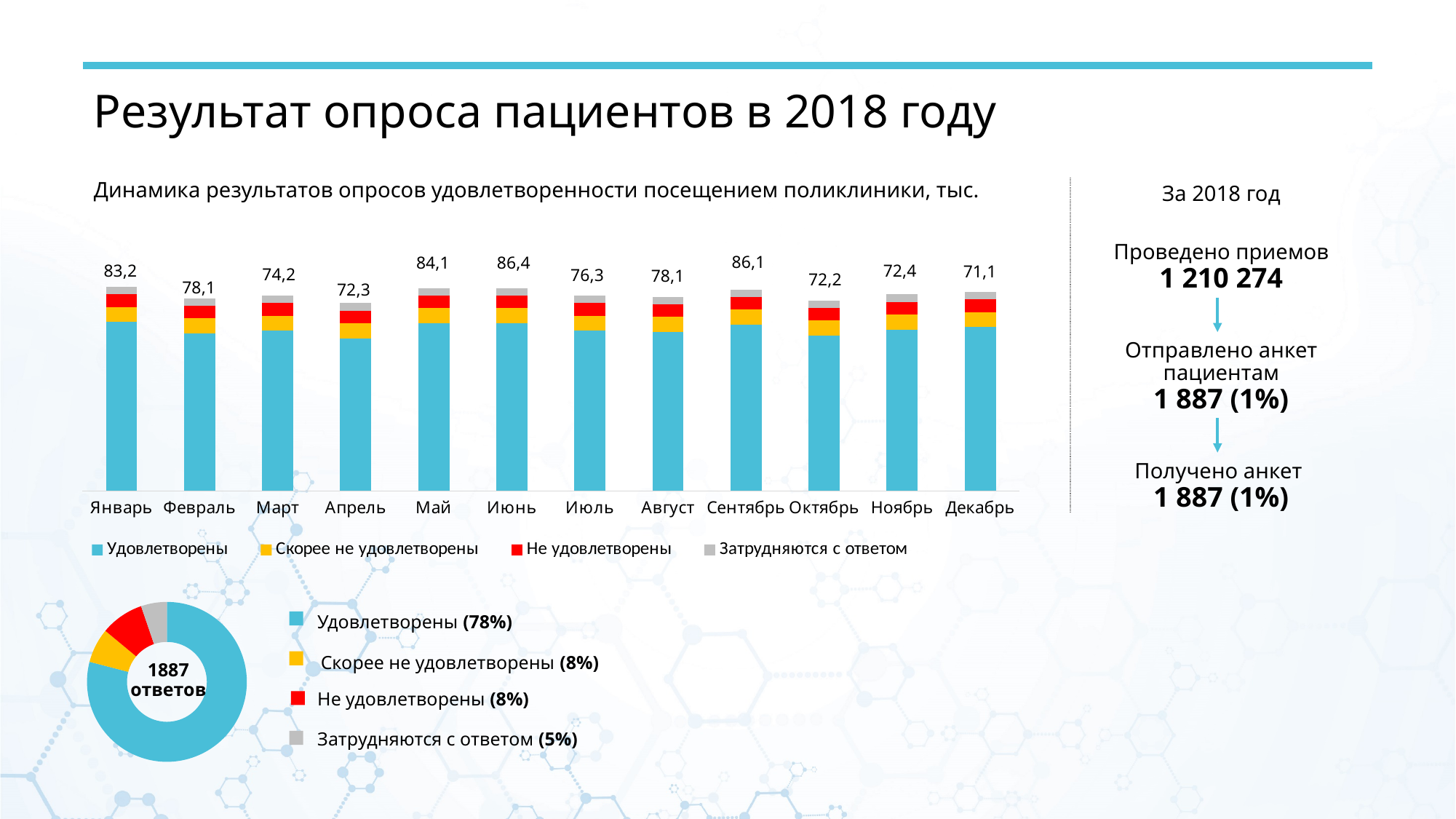
In the bar chart, what is the difference between the labeled totals for Май and Октябрь? 11,9 How many months are shown on the x axis of the bar chart? 12 In the donut chart, what share is labeled for Удовлетворены? 78% What number of responses is shown in the center of the donut chart? 1887 ответов In the bar chart, what is the total value labeled for Апрель? 72,3 How many series does the legend of the bar chart list? 4 In the bar chart, which is larger: the labeled total for Январь or for Июль? Январь In the donut chart, what share is labeled for Затрудняются с ответом? 5% In the bar chart, what is the total value labeled for Июнь? 86,4 In the bar chart, which month has the highest labeled total? Июнь In the bar chart, which month has the lowest labeled total? Декабрь What kind of chart is the chart at the top of the slide? Stacked bar chart